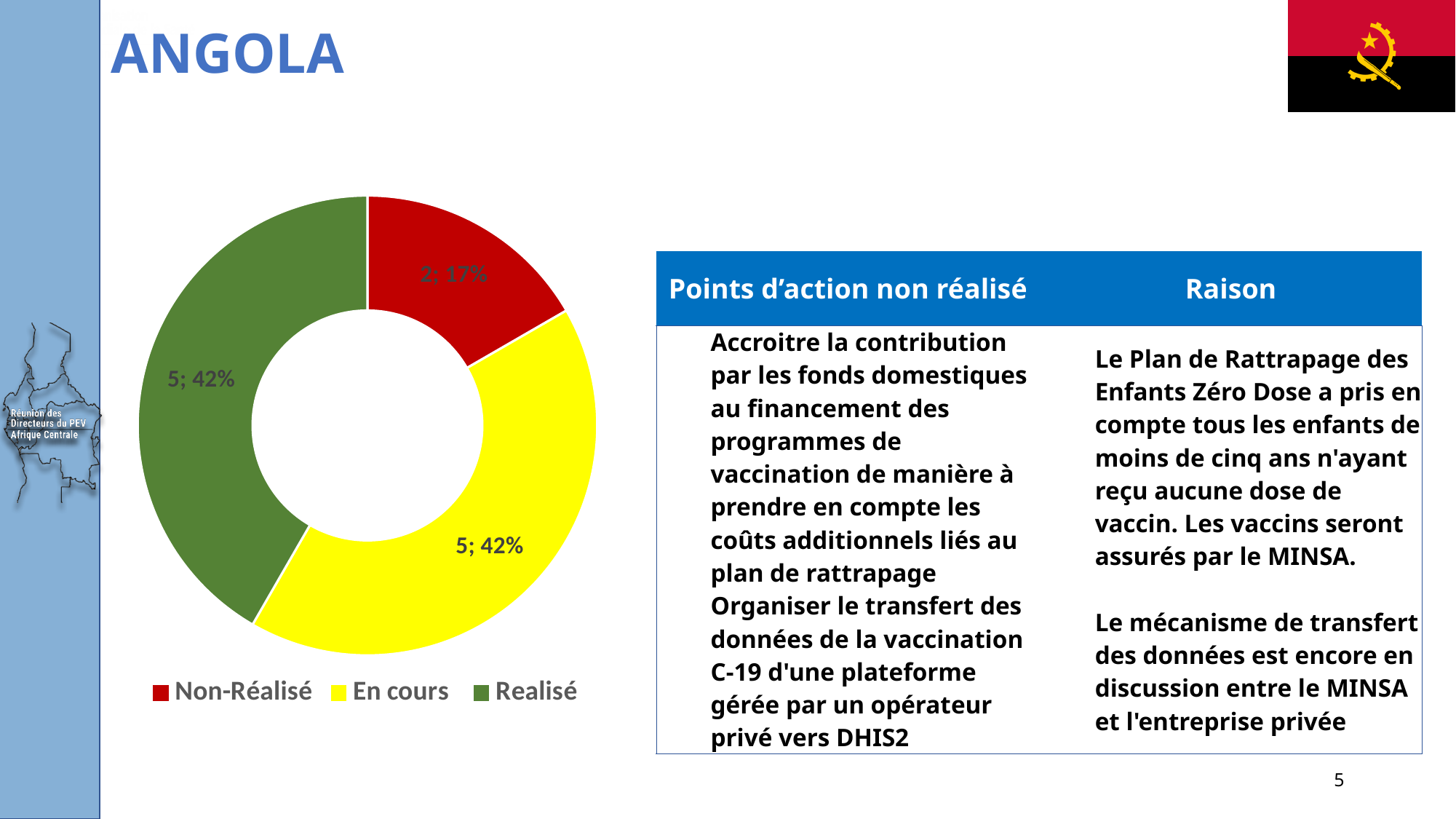
What is the count shown for the Non-Réalisé slice? 2 What is the count shown for the Realisé slice? 5 What is the difference between the count for En cours and the count for Non-Réalisé? 3 What is the count shown for the En cours slice? 5 How many entries does the legend of the doughnut chart list? 3 What kind of chart is shown on the slide? Doughnut (pie) chart Which is larger, the count for Realisé or the count for Non-Réalisé? Realisé What share of the doughnut chart does Non-Réalisé represent? 17% Which category has the smallest slice in the doughnut chart? Non-Réalisé How many categories does the doughnut chart show? 3 What share of the doughnut chart does Realisé represent? 42% What colour is used for the En cours slice in the doughnut chart? Yellow